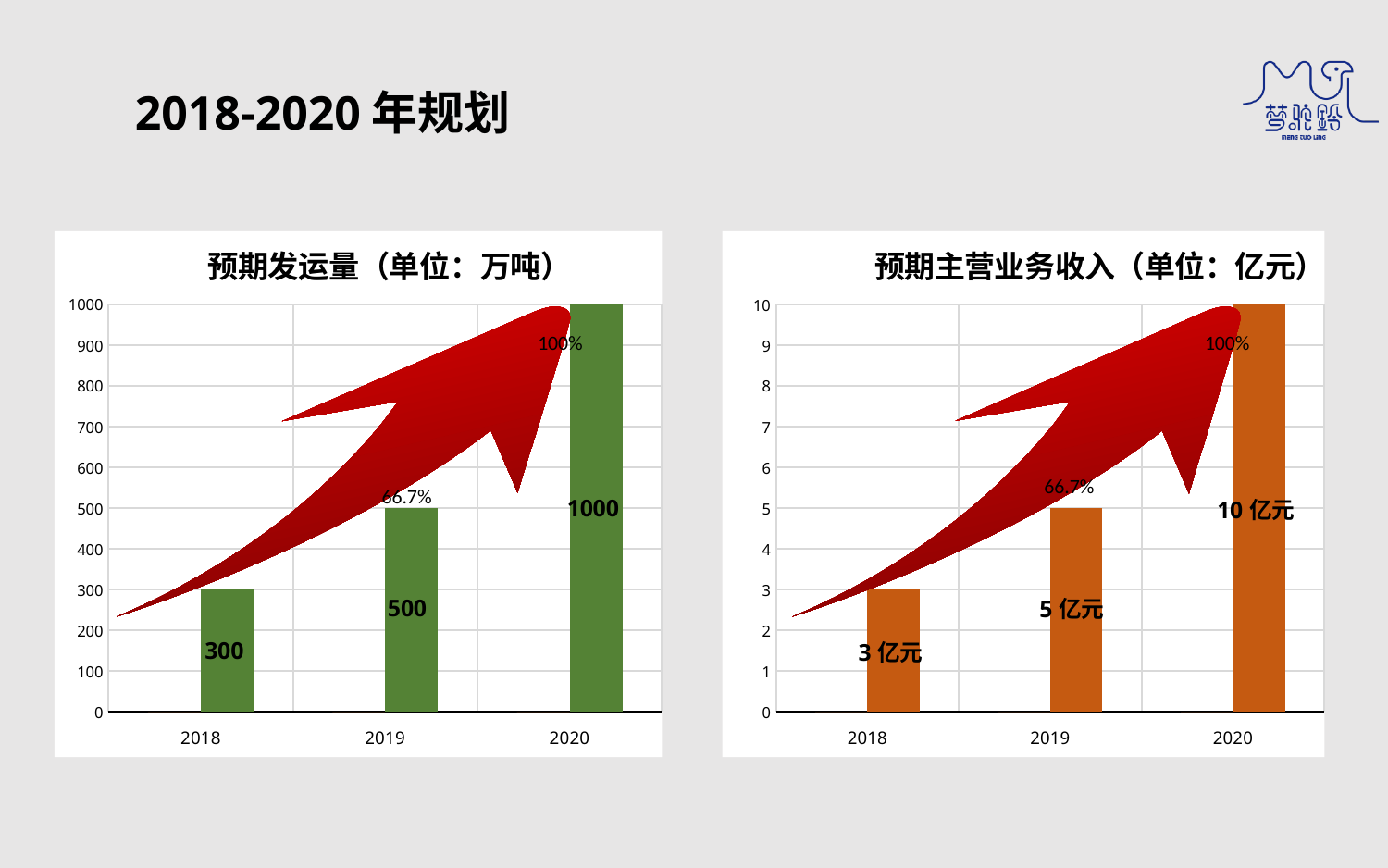
In the left chart (预期发运量), which year has the highest value? 2020 In the left chart (预期发运量), which is larger, the value for 2018 or the value for 2019? 2019 In the right chart (预期主营业务收入), do the values rise or fall from 2018 to 2020? rise What kind of chart is the left chart (预期发运量)? bar chart In the left chart (预期发运量), what is the difference between the 2020 and 2019 values? 500 In the left chart (预期发运量), what is the value for 2020? 1000 In the left chart (预期发运量), what is the value for 2018? 300 In the right chart (预期主营业务收入), what is the value for 2019? 5 亿元 In the right chart (预期主营业务收入), which year has the lowest value? 2018 In the right chart (预期主营业务收入), what is the value for 2020? 10 亿元 In the right chart (预期主营业务收入), what is the difference between the 2019 and 2018 values? 2 亿元 How many years are shown on the x axis of the right chart (预期主营业务收入)? 3